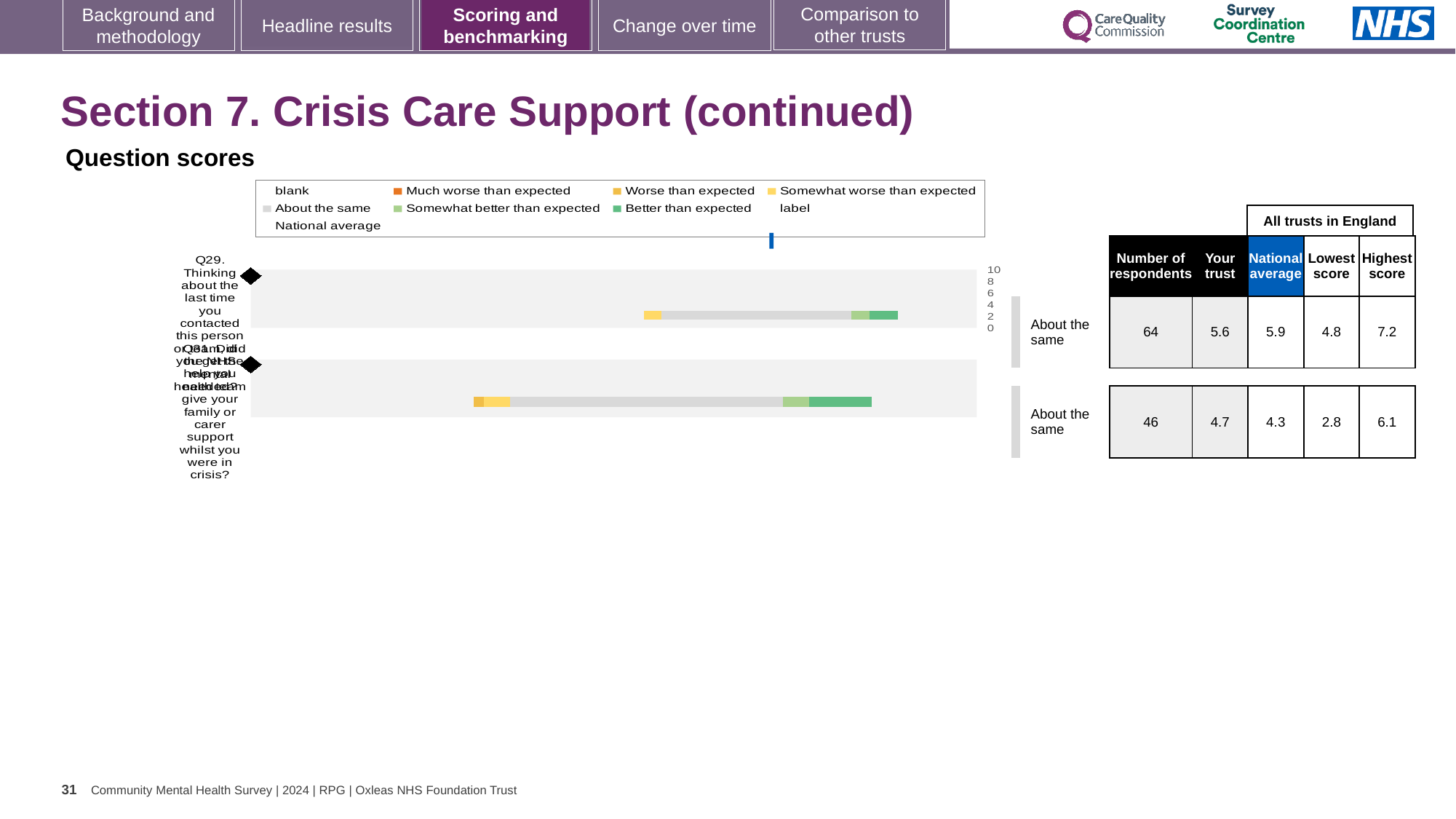
In the table next to the chart, how many respondents are listed for Q29? 64 Which question has the larger number of respondents? Q29 For the second question (Q31), which is larger: the 'Your trust' score or the national average? Your trust What is the national average score for Q29? 5.9 For Q29, which is larger: the 'Your trust' score or the national average? National average What is the highest score among all trusts in England for the second question (Q31)? 6.1 What is the 'Your trust' score for Q29? 5.6 What is the difference between the highest score and the lowest score for Q29? 2.4 How many questions are plotted in the question scores chart? 2 What kind of chart is used to show the question scores on this slide? bar chart What is the lowest score among all trusts in England for the second question (Q31)? 2.8